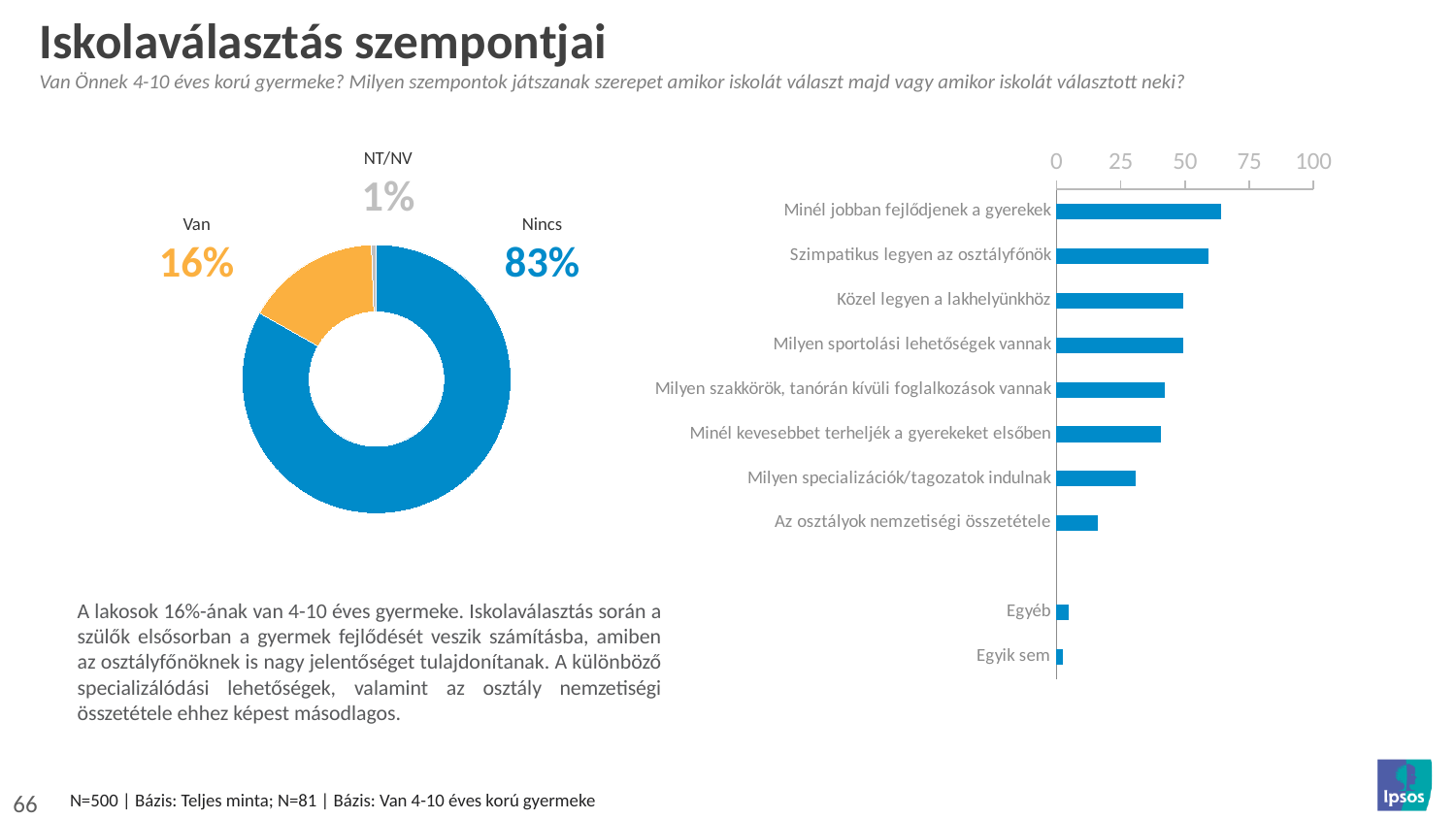
On the donut chart on the left, what is the difference in percentage points between "Nincs" and "Van"? 67 percentage points On the bar chart on the right, is the value for "Az osztályok nemzetiségi összetétele" greater or less than 25? less On the bar chart on the right, is the value for "Szimpatikus legyen az osztályfőnök" greater or less than 50? greater On the bar chart on the right, how many categories are shown? 10 On the donut chart on the left, how many categories are shown? 3 On the donut chart on the left, what percentage is shown for "NT/NV"? 1% On the donut chart on the left, what percentage is shown for "Van"? 16% On the bar chart on the right, which is larger: the value for "Milyen specializációk/tagozatok indulnak" or for "Az osztályok nemzetiségi összetétele"? Milyen specializációk/tagozatok indulnak On the donut chart on the left, what percentage is shown for "Nincs"? 83% On the donut chart on the left, which category has the largest share? Nincs On the bar chart on the right, which category has the lowest value? Egyik sem On the bar chart on the right, which category has the highest value? Minél jobban fejlődjenek a gyerekek